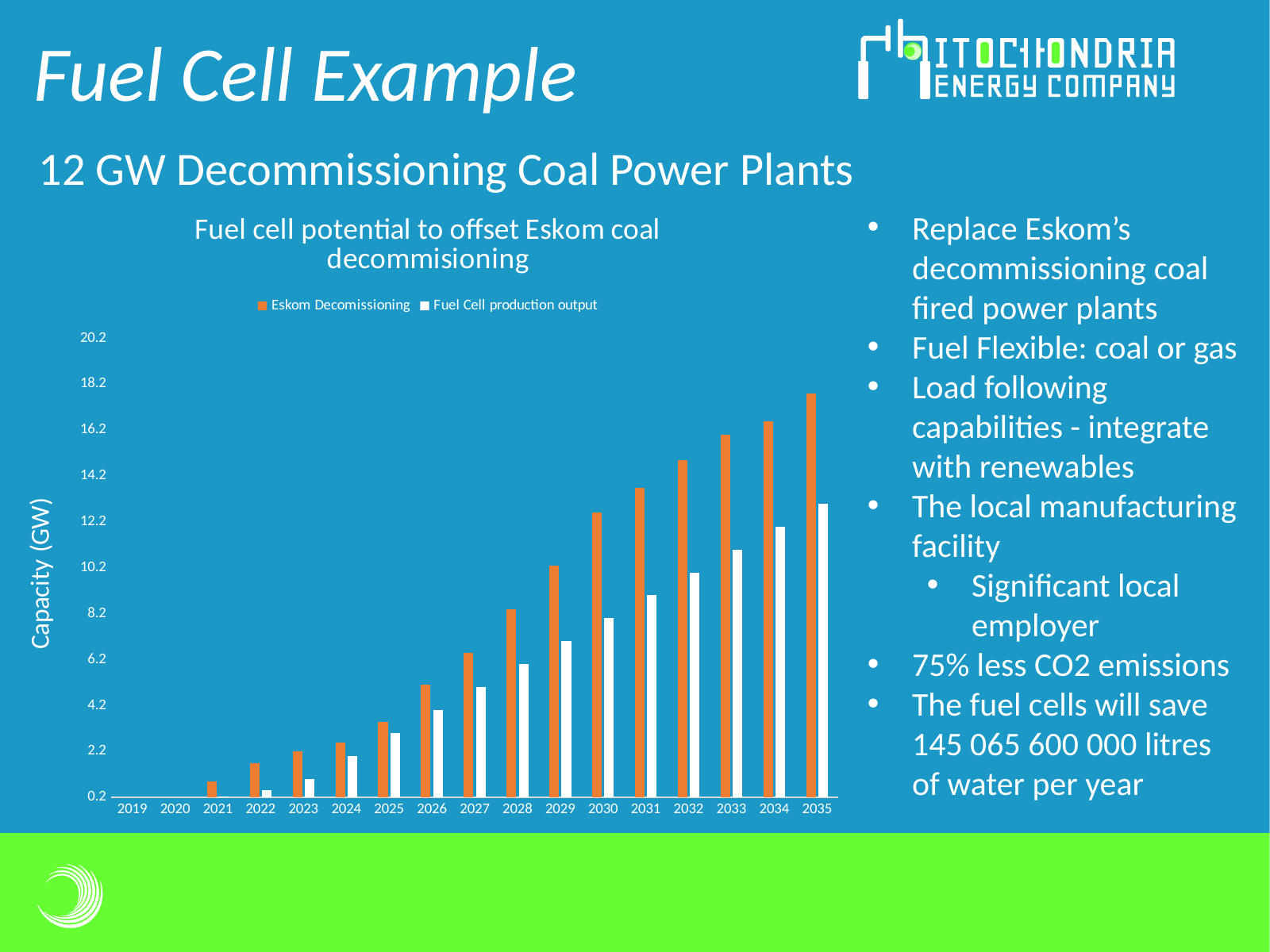
Which year has the highest Eskom Decommissioning value? 2035 How many years are shown on the x axis of the chart? 17 Is the Eskom Decommissioning value for 2027 greater or less than 8.2? less What is the title of the chart's vertical axis? Capacity (GW) Which year has the highest Fuel Cell production output value? 2035 Which series is shown in orange in the chart? Eskom Decommissioning How many series does the chart legend list? 2 Do the Eskom Decommissioning values rise or fall from 2021 to 2035? Rise Is the Eskom Decommissioning value for 2035 greater or less than 16.2? greater Is the Fuel Cell production output value for 2035 greater or less than 10.2? greater What kind of chart is shown on the slide? Bar chart In 2035, which is larger: Eskom Decommissioning or Fuel Cell production output? Eskom Decommissioning